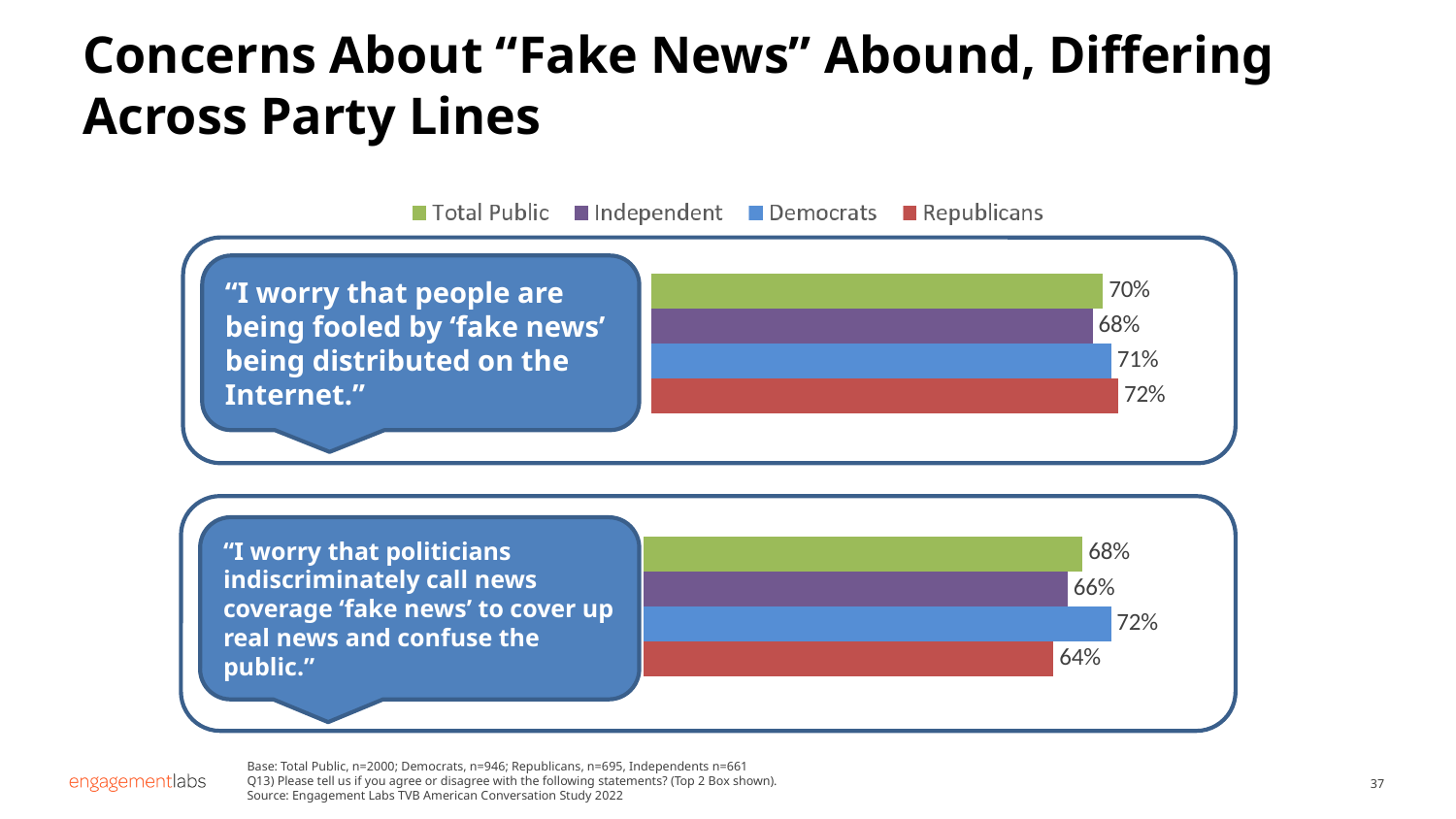
In the top chart ("I worry that people are being fooled by 'fake news'..."), what is the difference between the Republicans value and the Independent value? 4% In the top chart ("I worry that people are being fooled by 'fake news'..."), which group has the lowest value? Independent In the bottom chart ("I worry that politicians indiscriminately call news coverage 'fake news'..."), which group has the highest value? Democrats In the bottom chart ("I worry that politicians indiscriminately call news coverage 'fake news'..."), what is the value for Democrats? 72% In the top chart ("I worry that people are being fooled by 'fake news' being distributed on the Internet"), what is the value for Republicans? 72% In the bottom chart ("I worry that politicians indiscriminately call news coverage 'fake news'..."), what is the difference between the Democrats value and the Republicans value? 8% What kind of chart is used on this slide? Bar chart In the bottom chart ("I worry that politicians indiscriminately call news coverage 'fake news'..."), which is larger, the value for Total Public or the value for Republicans? Total Public In the top chart ("I worry that people are being fooled by 'fake news'..."), what is the value for Total Public? 70% In the bottom chart ("I worry that politicians indiscriminately call news coverage 'fake news'..."), what is the value for Republicans? 64% How many series does the legend list? 4 In the bottom chart ("I worry that politicians indiscriminately call news coverage 'fake news'..."), which group has the lowest value? Republicans